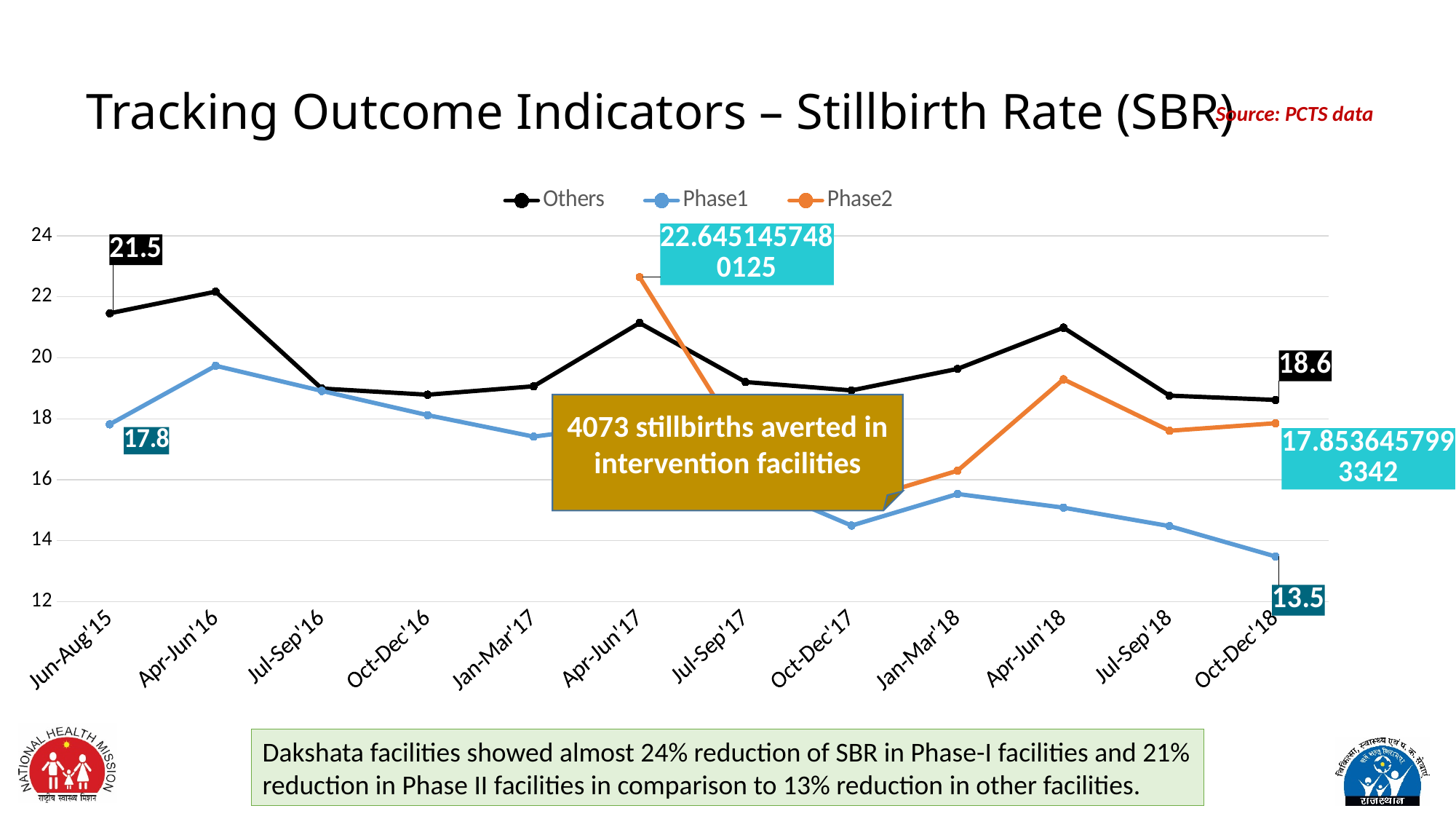
What is the value for Phase1 in Oct-Dec'18? 13.5 By how much did the Phase1 value fall from Jun-Aug'15 to Oct-Dec'18? 4.3 How many time periods are shown on the x axis? 12 What is the value for Phase1 in Jun-Aug'15? 17.8 By how much did the Others value fall from Jun-Aug'15 to Oct-Dec'18? 2.9 What is the value for Others in Oct-Dec'18? 18.6 What is the value for Others in Jun-Aug'15? 21.5 In which period does the Phase1 series reach its lowest value? Oct-Dec'18 Is the value for Phase1 in Oct-Dec'17 greater or less than 16? less What type of chart is shown on the slide? line chart In Jun-Aug'15, which series has the larger value, Others or Phase1? Others How many series does the legend list? 3